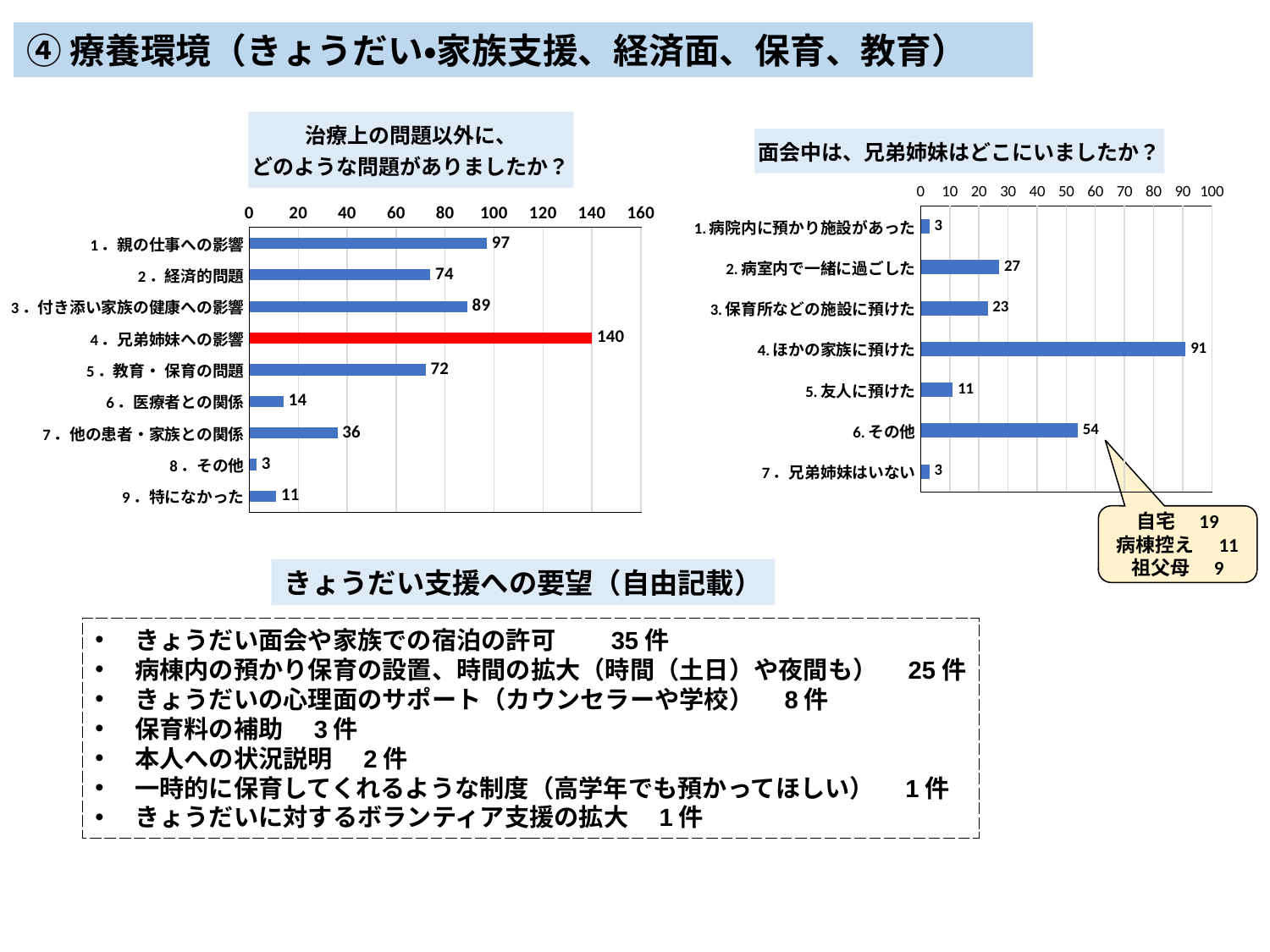
In the left chart (治療上の問題以外に、どのような問題がありましたか？), what is the value for 2．経済的問題? 74 What kind of chart is the right chart (面会中は、兄弟姉妹はどこにいましたか？)? Bar chart In the right chart (面会中は、兄弟姉妹はどこにいましたか？), which category has the highest value? 4.ほかの家族に預けた In the right chart (面会中は、兄弟姉妹はどこにいましたか？), how many categories are shown? 7 In the left chart (治療上の問題以外に、どのような問題がありましたか？), which bar is coloured red? 4．兄弟姉妹への影響 In the right chart (面会中は、兄弟姉妹はどこにいましたか？), what is the difference between 6.その他 and 5.友人に預けた? 43 In the left chart (治療上の問題以外に、どのような問題がありましたか？), how many categories are shown? 9 In the left chart (治療上の問題以外に、どのような問題がありましたか？), what is the value for 4．兄弟姉妹への影響? 140 In the left chart (治療上の問題以外に、どのような問題がありましたか？), which category has the lowest value? 8．その他 In the left chart (治療上の問題以外に、どのような問題がありましたか？), what is the difference between 1．親の仕事への影響 and 3．付き添い家族の健康への影響? 8 In the right chart (面会中は、兄弟姉妹はどこにいましたか？), what is the value for 4.ほかの家族に預けた? 91 In the right chart (面会中は、兄弟姉妹はどこにいましたか？), which is larger, 2.病室内で一緒に過ごした or 3.保育所などの施設に預けた? 2.病室内で一緒に過ごした